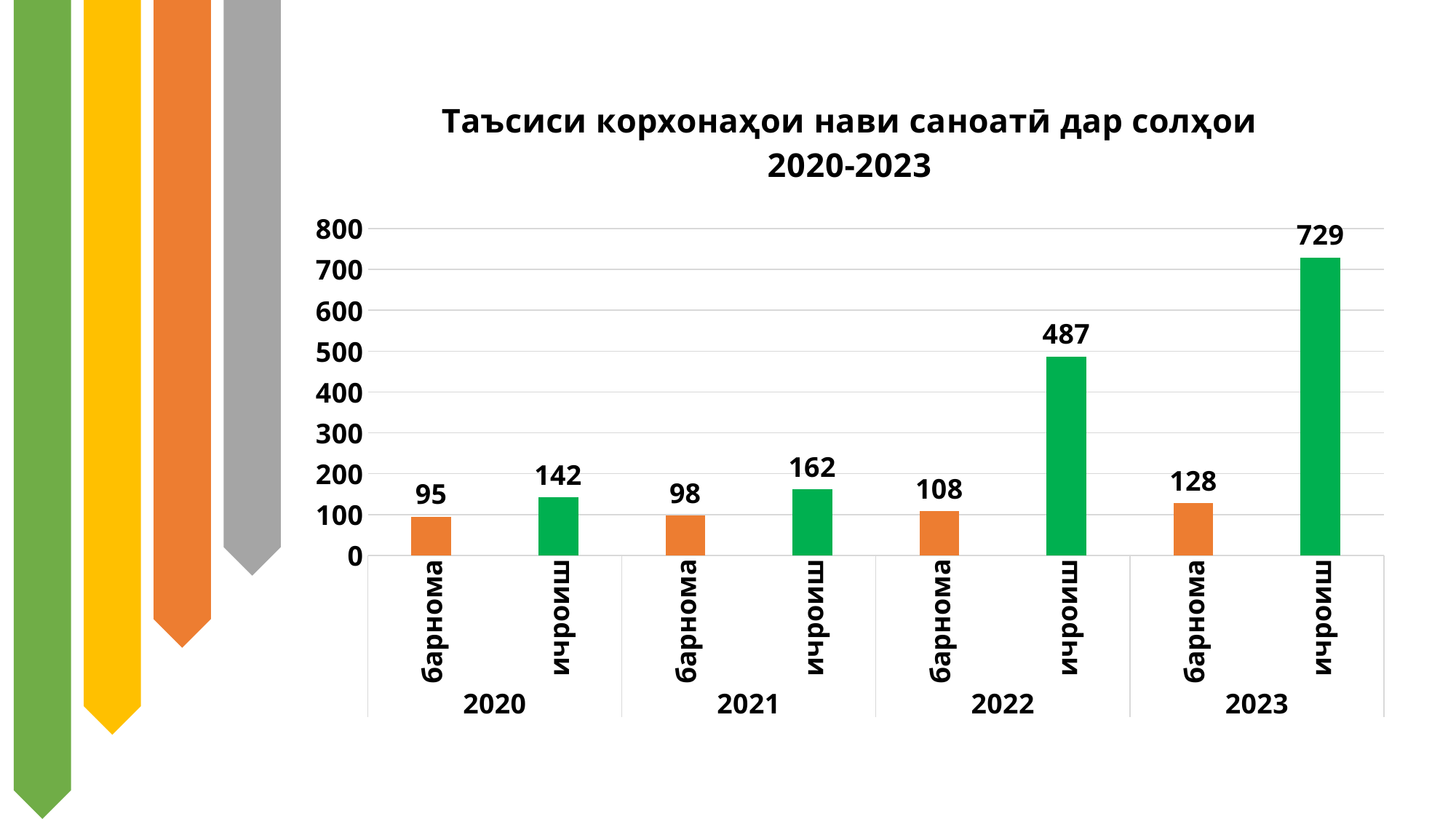
How many years are shown on the x axis? 4 What is the value of the иҷро bar for 2022? 487 Which is larger, the иҷро value for 2021 or the барнома value for 2023? иҷро 2021 What is the value of the барнома bar for 2021? 98 What kind of chart is shown on the slide? bar chart Which bar has the lowest value on the chart? барнома 2020 What is the value of the иҷро bar for 2023? 729 What is the difference between the иҷро and барнома values for 2022? 379 What is the value of the барнома bar for 2020? 95 Which bar has the highest value on the chart? иҷро 2023 What is the difference between the иҷро values for 2023 and 2022? 242 Do the иҷро values rise or fall from 2020 to 2023? rise